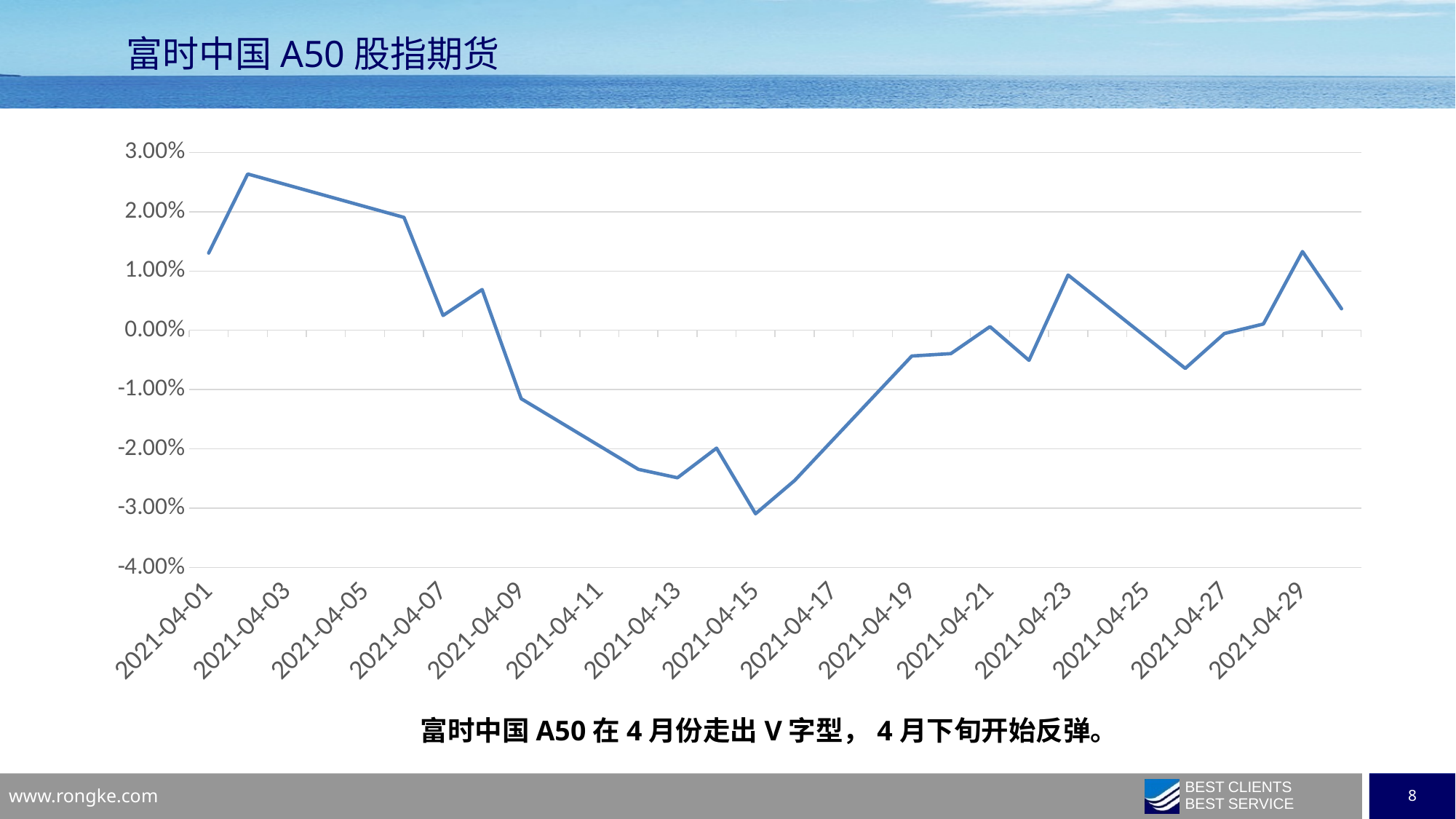
On which labeled date does the line reach its lowest point? 2021-04-15 Does the line generally rise or fall between 2021-04-03 and 2021-04-15? fall What is the title of the chart on the slide? 富时中国 A50 股指期货 Is the value for 2021-04-15 greater or less than -2.00%? less How many date labels are shown on the x axis? 15 Which is larger, the value for 2021-04-01 or the value for 2021-04-15? 2021-04-01 Is the value for 2021-04-01 greater or less than 1.00%? greater Is the value for 2021-04-13 greater or less than -2.00%? less What kind of chart is shown on the slide? line chart